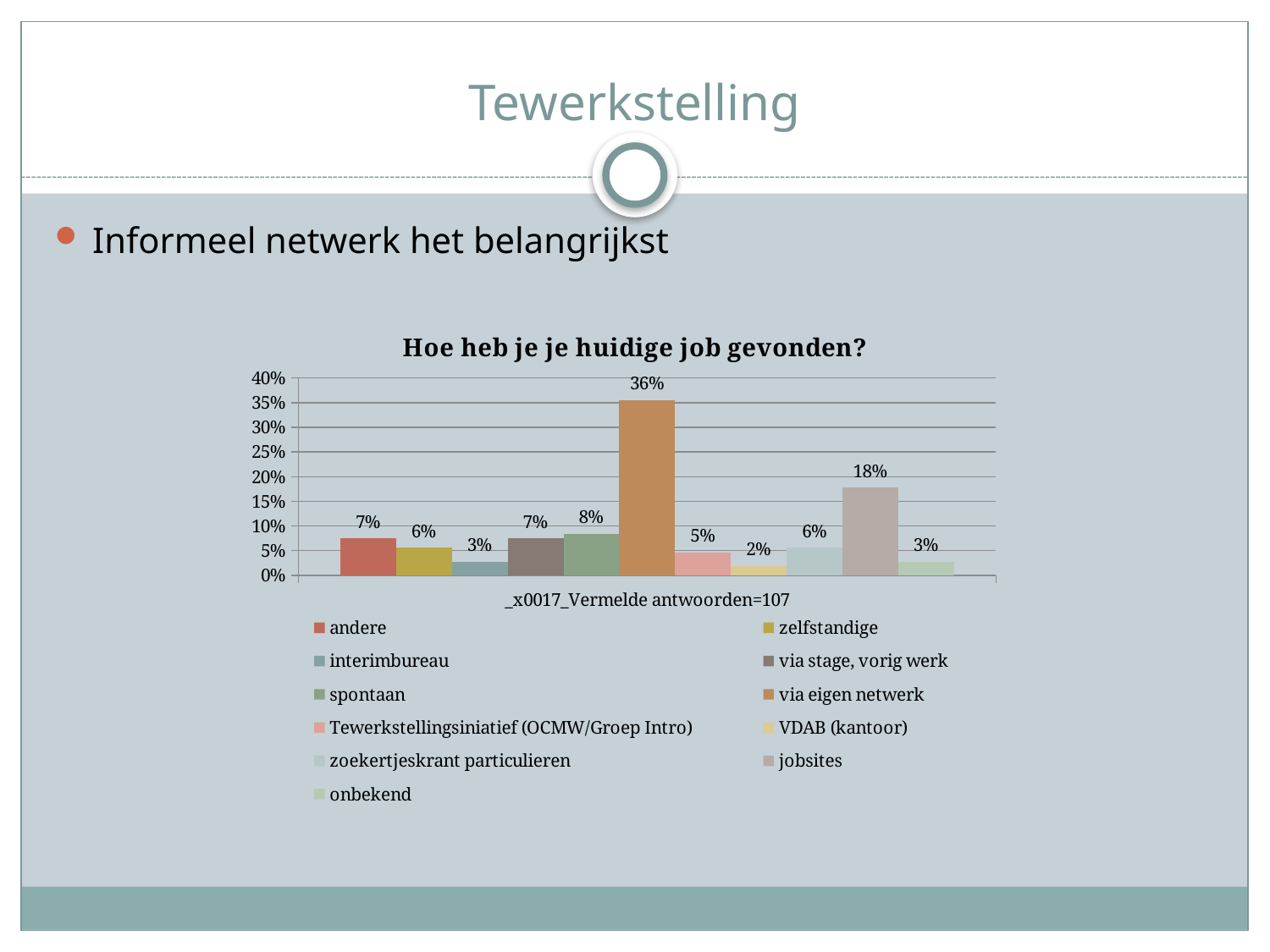
Which category has the highest value in the chart? via eigen netwerk What is the value for 'VDAB (kantoor)' in the chart? 2% What kind of chart is shown on the slide? bar chart What is the value for 'via eigen netwerk' in the chart 'Hoe heb je je huidige job gevonden?'? 36% Is the value for 'via eigen netwerk' greater or less than 30%? greater How many series does the legend list? 11 What is the title of the chart on the slide? Hoe heb je je huidige job gevonden? Which is larger: the value for 'spontaan' or the value for 'interimbureau'? spontaan What is the value for 'spontaan' in the chart? 8% What is the difference between the values for 'via eigen netwerk' and 'jobsites'? 18% Which category has the lowest value in the chart? VDAB (kantoor) What is the value for 'jobsites' in the chart? 18%